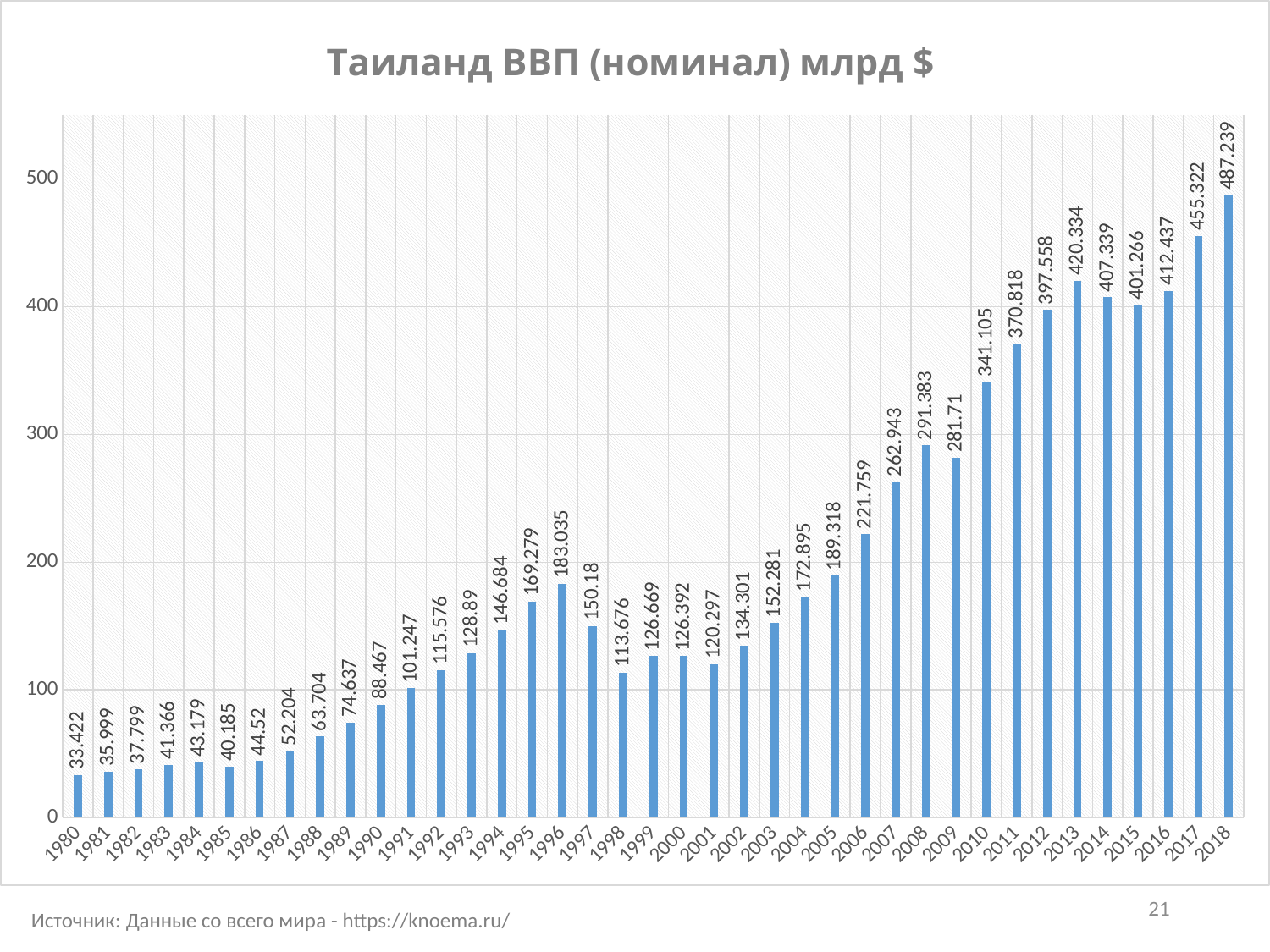
Which year has the lowest value? 1980 What is the difference between the values for 2018 and 2017? 31.917 Is the value for 2010 greater or less than 300? greater What is the value for 1980? 33.422 Which is larger, the value for 2013 or the value for 2014? 2013 Which year has the highest value? 2018 What is the difference between the values for 1996 and 1997? 32.855 What is the value for 2018? 487.239 What is the title of the chart? Таиланд ВВП (номинал) млрд $ What type of chart is shown on the slide? bar chart How many years are shown on the x axis? 39 What is the value for 1996? 183.035